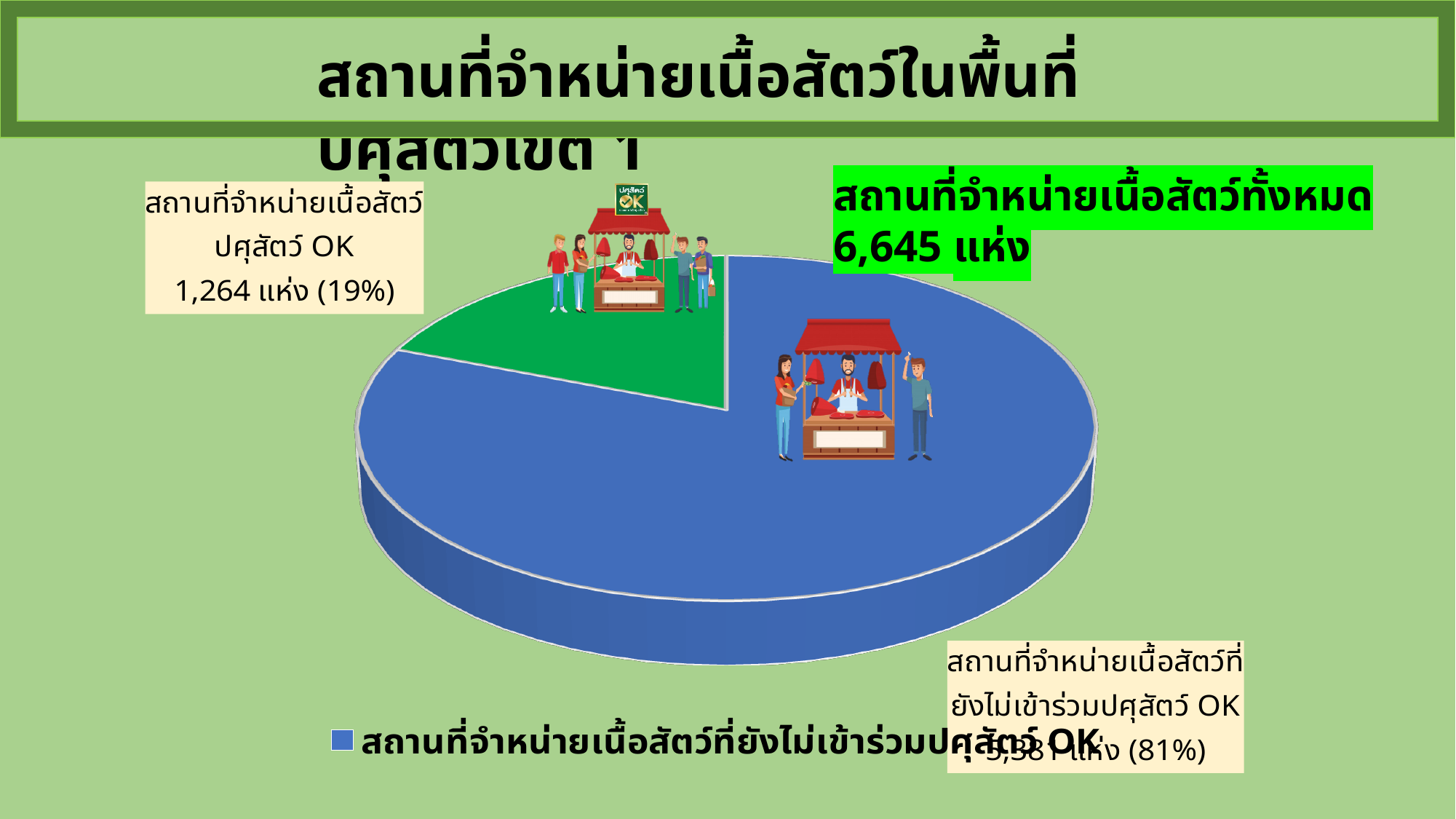
Which slice of the pie chart is the smallest? สถานที่จำหน่ายเนื้อสัตว์ปศุสัตว์ OK What kind of chart is shown on the slide? Pie chart What is the total number of meat-selling locations shown on the slide? 6,645 แห่ง Which is larger: the share of locations that are ปศุสัตว์ OK or the share that have not yet joined ปศุสัตว์ OK? ยังไม่เข้าร่วมปศุสัตว์ OK What share of the pie does สถานที่จำหน่ายเนื้อสัตว์ที่ยังไม่เข้าร่วมปศุสัตว์ OK represent? 81% How many meat-selling locations are ปศุสัตว์ OK according to the pie chart label? 1,264 แห่ง What colour is the slice for สถานที่จำหน่ายเนื้อสัตว์ปศุสัตว์ OK? Green What share of the pie does สถานที่จำหน่ายเนื้อสัตว์ปศุสัตว์ OK represent? 19% What colour is the slice for locations that have not yet joined ปศุสัตว์ OK? Blue How many entries does the legend below the pie chart list? 1 Which slice of the pie chart is the largest? สถานที่จำหน่ายเนื้อสัตว์ที่ยังไม่เข้าร่วมปศุสัตว์ OK How many slices does the pie chart have? 2